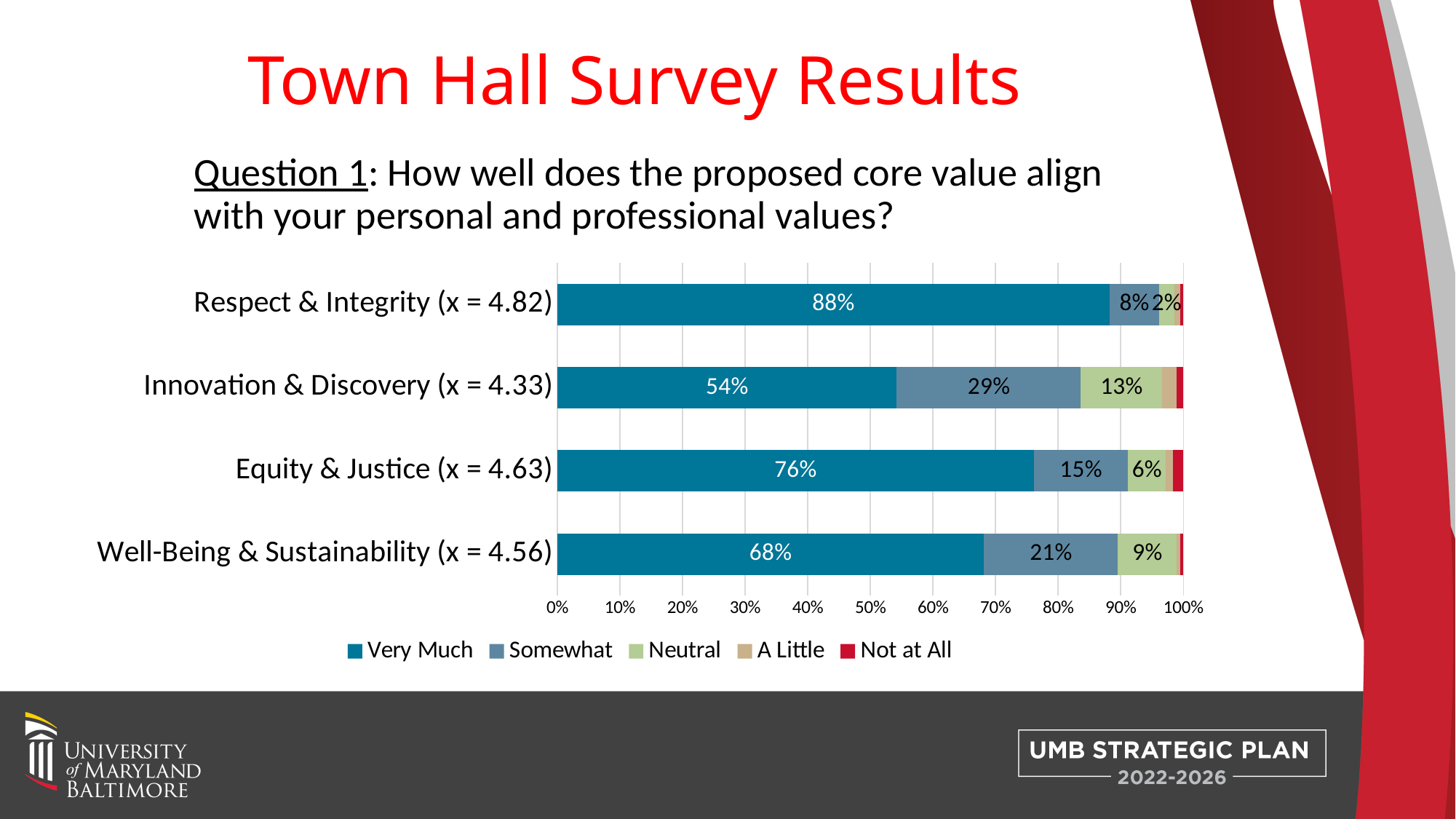
Which core value has the highest Very Much percentage? Respect & Integrity How many core values (categories) are plotted in the chart? 4 What is the Very Much percentage for Respect & Integrity? 88% What is the difference between the Very Much percentages for Equity & Justice and Well-Being & Sustainability? 8% Which is larger: the Somewhat percentage for Equity & Justice or for Well-Being & Sustainability? Well-Being & Sustainability Is the Very Much value for Innovation & Discovery greater or less than 60%? less Which core value has the lowest Very Much percentage? Innovation & Discovery How many series does the legend list? 5 What is the Somewhat percentage for Innovation & Discovery? 29% Which legend entry is shown in red? Not at All What kind of chart is shown on the slide? stacked bar chart What is the Neutral percentage for Well-Being & Sustainability? 9%